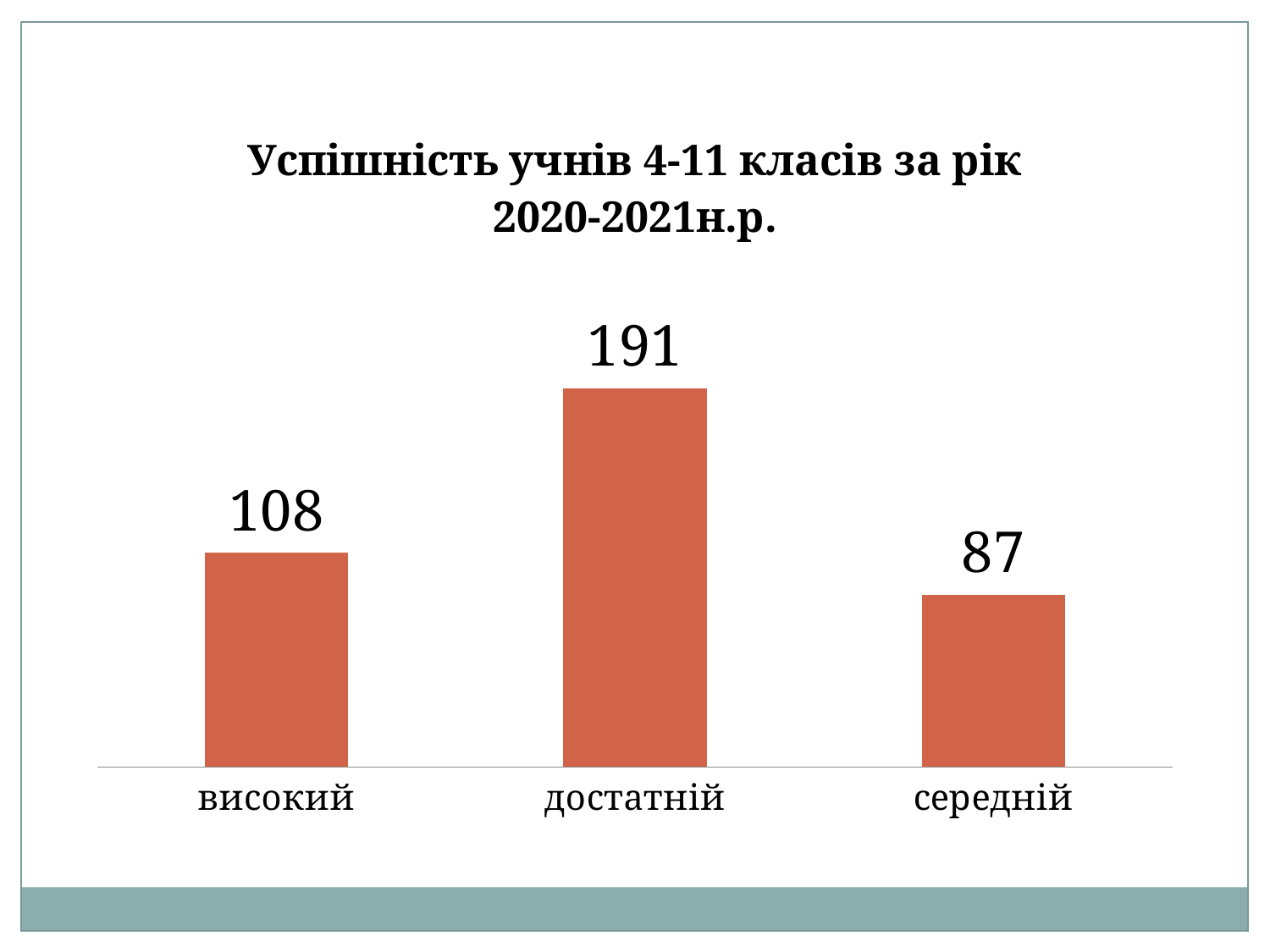
What is the value for високий? 108 What is the value for середній? 87 What is the total of the three values shown on the chart? 386 What kind of chart is shown on the slide? bar chart Which category has the highest value? достатній What is the value for достатній? 191 What is the difference between the values for достатній and високий? 83 What is the difference between the values for високий and середній? 21 Which is larger, the value for високий or the value for середній? високий How many categories are shown on the chart? 3 Which category has the lowest value? середній What is the title of the chart? Успішність учнів 4-11 класів за рік 2020-2021н.р.